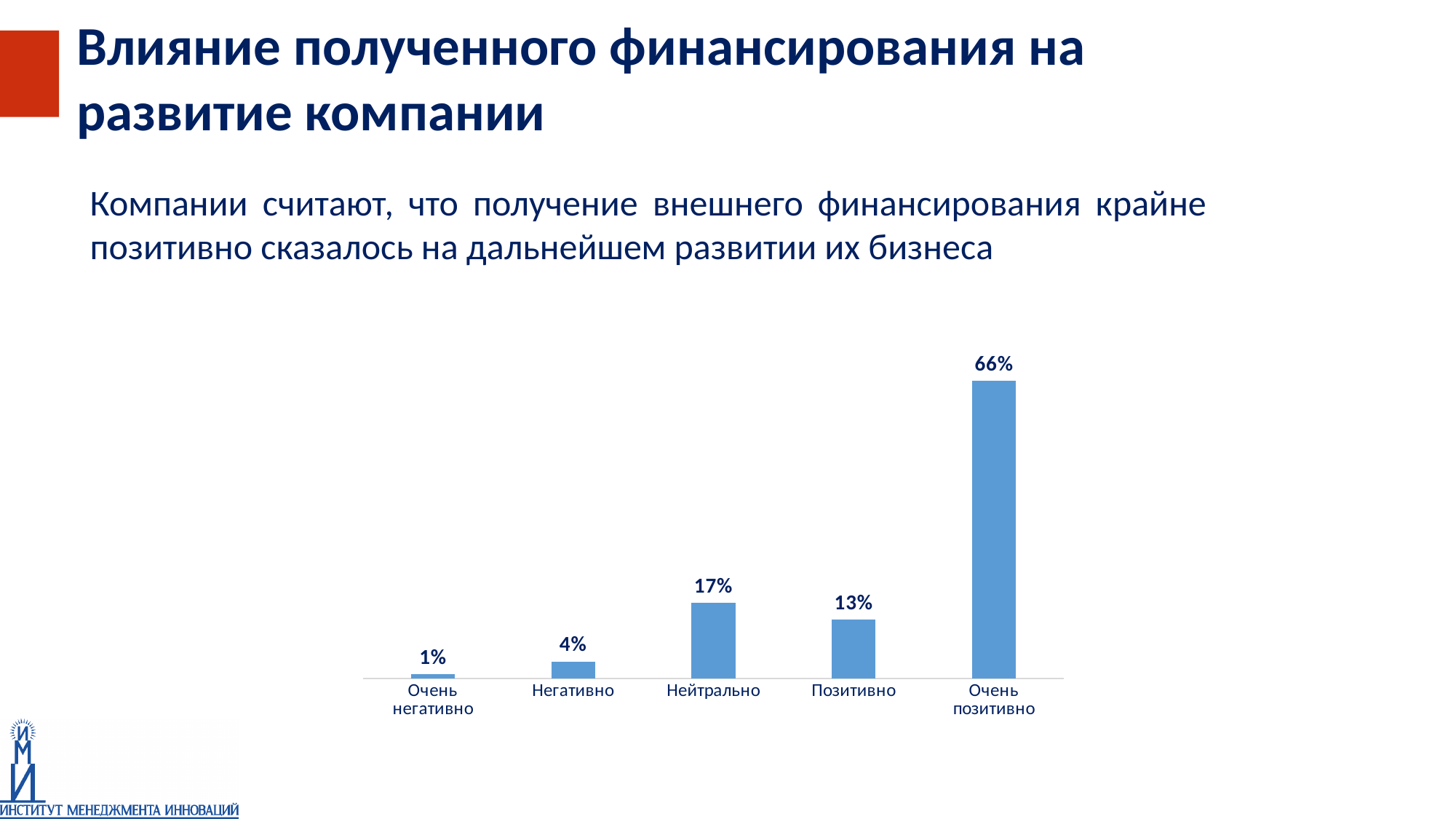
What is the difference between the values for "Нейтрально" and "Позитивно"? 4% What is the difference between the values for "Очень позитивно" and "Нейтрально"? 49% Which category has the highest value? Очень позитивно How many categories are shown in the chart? 5 Which is larger, the value for "Нейтрально" or the value for "Позитивно"? Нейтрально What colour are the bars in the chart? Blue What is the value for "Нейтрально"? 17% What kind of chart is shown on the slide? Bar chart Which category has the lowest value? Очень негативно What is the value for "Позитивно"? 13% What is the value for "Негативно"? 4% What is the value for "Очень позитивно"? 66%